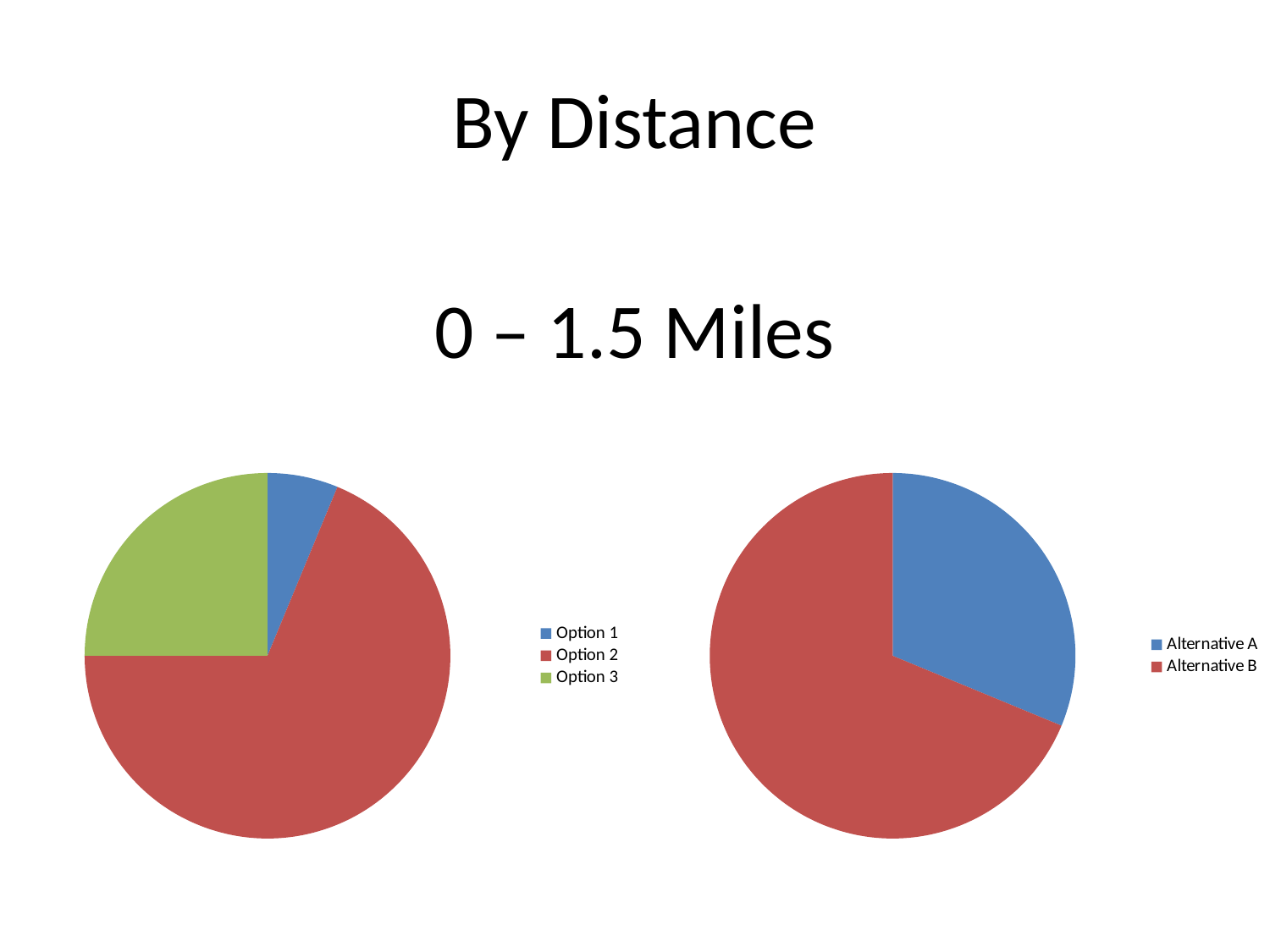
In the left pie chart, which is larger, Option 3 or Option 1? Option 3 In the left pie chart, which category has the smallest slice? Option 1 In the right pie chart, which category has the smallest slice? Alternative A In the left pie chart, which category has the largest slice? Option 2 In the right pie chart, which category has the largest slice? Alternative B In the left pie chart, what colour is the Option 3 slice? Green What kind of chart is the left chart on the slide? Pie chart In the right pie chart, how many slices are there? 2 In the left pie chart, how many slices are there? 3 What kind of chart is the right chart on the slide? Pie chart How many entries does the legend of the left pie chart list? 3 In the right pie chart, which is larger, Alternative A or Alternative B? Alternative B